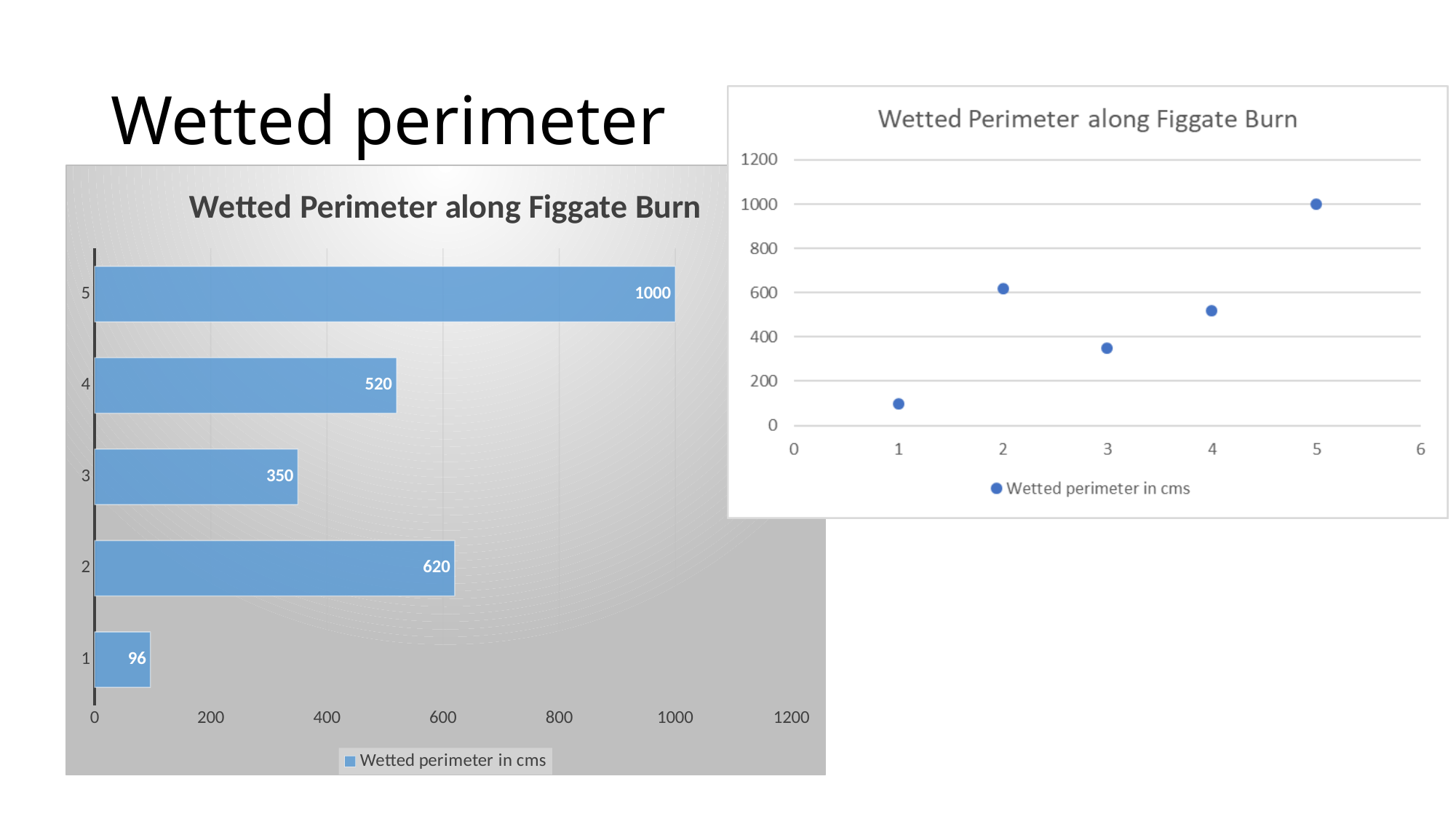
In the bar chart on the left, which site has the lowest wetted perimeter? 1 In the bar chart on the left, what is the value for site 2? 620 What kind of chart is the chart on the right of the slide? scatter chart In the scatter chart on the right, is the value at x = 4 greater or less than 400? greater What series name does the legend of the bar chart on the left show? Wetted perimeter in cms In the bar chart on the left, which is larger, the value for site 2 or the value for site 4? site 2 In the bar chart on the left, which site has the highest wetted perimeter? 5 In the bar chart on the left, what is the difference between the values for site 4 and site 3? 170 In the bar chart on the left, what is the value for site 1? 96 In the bar chart on the left, what is the wetted perimeter value for site 5? 1000 How many bars are shown in the bar chart on the left? 5 In the scatter chart on the right, is the value at x = 3 greater or less than 400? less